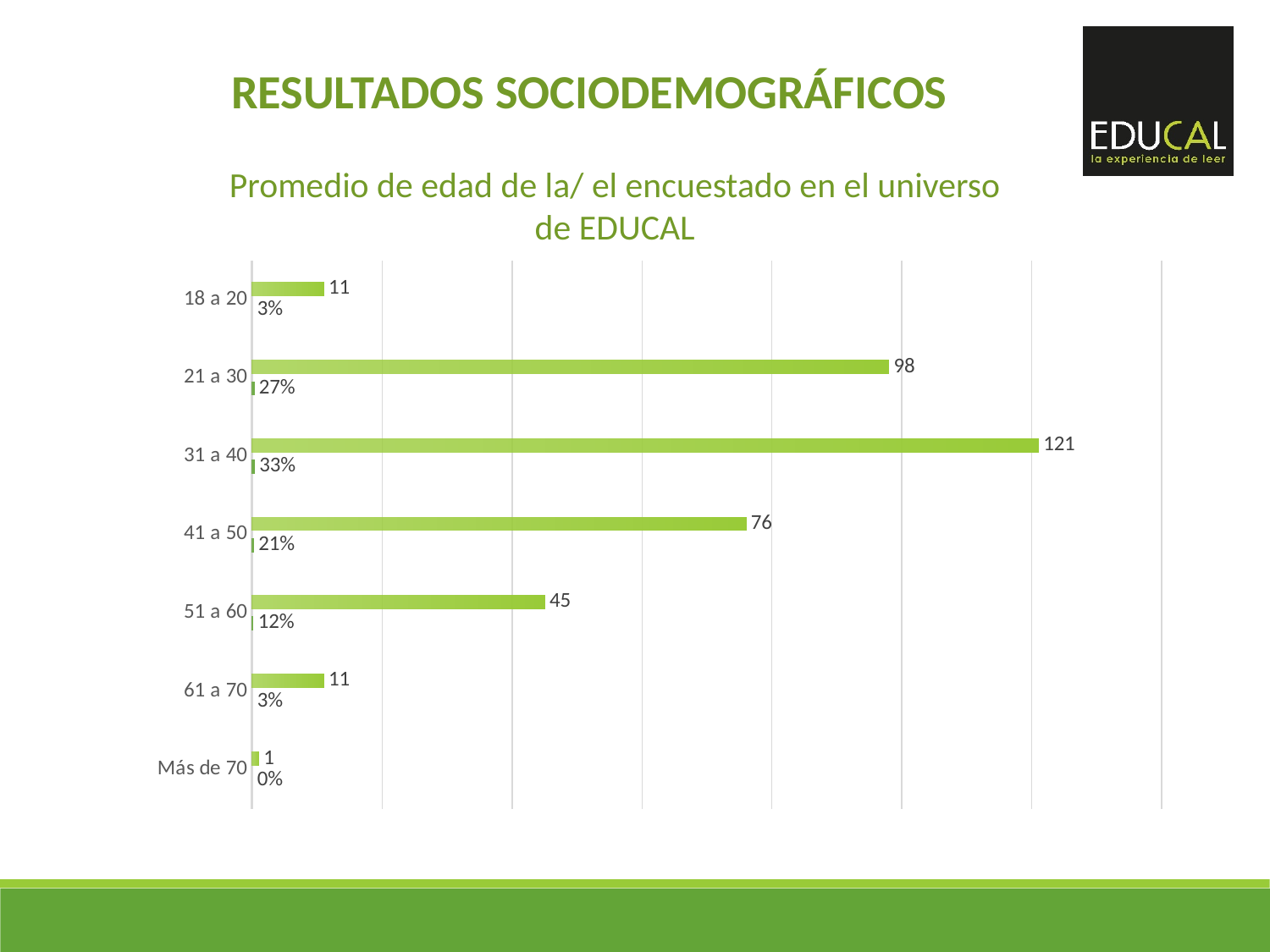
What is the difference between the counts for 31 a 40 and 21 a 30? 23 What is the count value for the 31 a 40 age group? 121 What is the title of the chart? Promedio de edad de la/ el encuestado en el universo de EDUCAL Which has a larger count, 21 a 30 or 41 a 50? 21 a 30 Which age group has the lowest count? Más de 70 What type of chart is shown on the slide? Bar chart What is the count value for the 51 a 60 age group? 45 What percentage is shown for the 41 a 50 age group? 21% How many age groups are shown in the chart? 7 What percentage is shown for the 21 a 30 age group? 27% Which age group has the highest count? 31 a 40 What is the difference between the counts for 41 a 50 and 51 a 60? 31